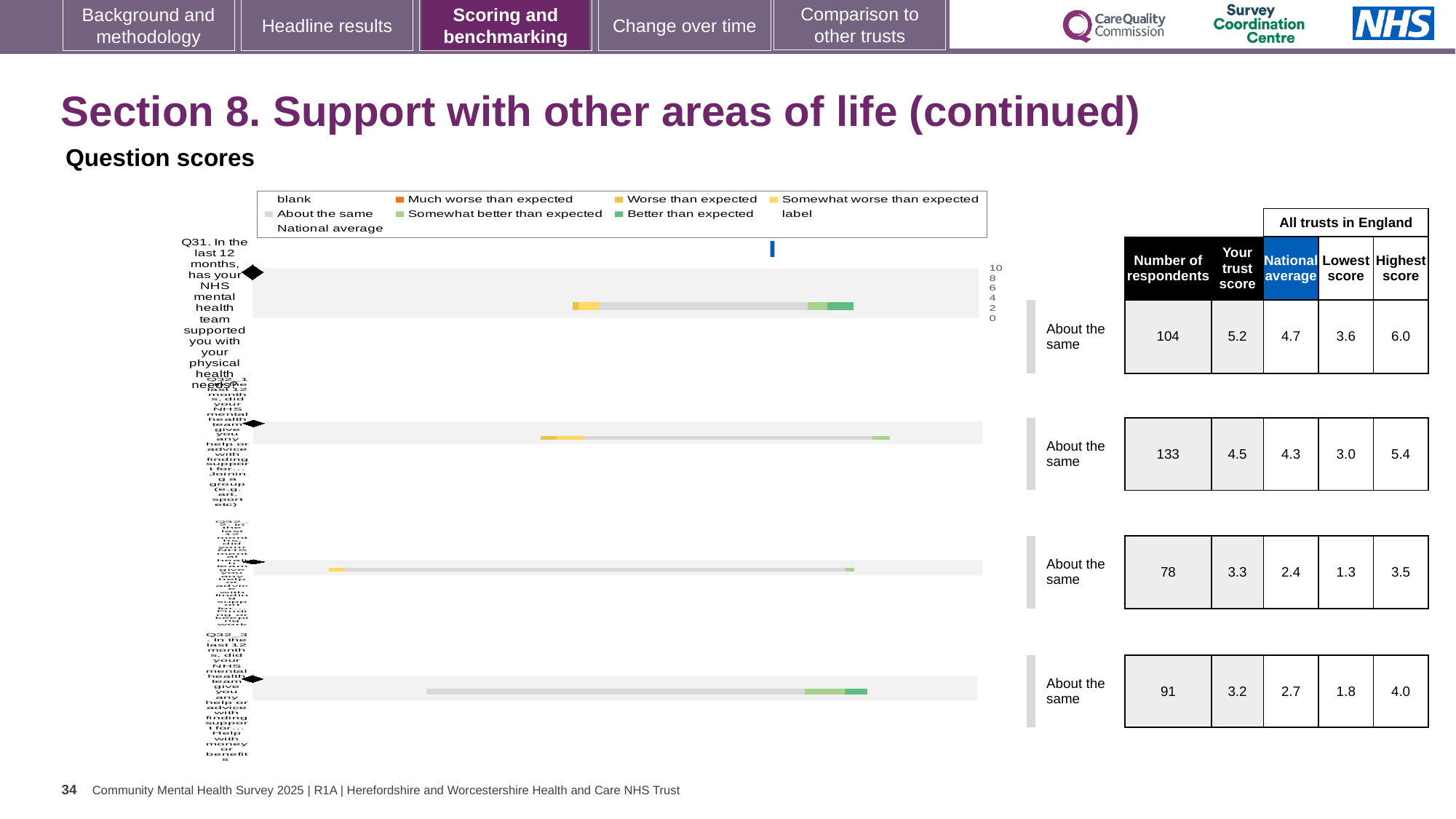
Which colour in the legend represents 'Much worse than expected'? orange What benchmark category is shown beside the bar for Q31? About the same What benchmark category is shown beside the bottom bar (Q32_3)? About the same Which colour in the legend represents 'Better than expected'? green How many of the four question bars are labelled 'About the same'? 4 How many question bars are plotted in the chart? 4 What kind of chart is shown on the slide? bar chart What is the first question label listed at the top of the chart? Q31. In the last 12 months, has your NHS mental health team supported you with your physical health needs?